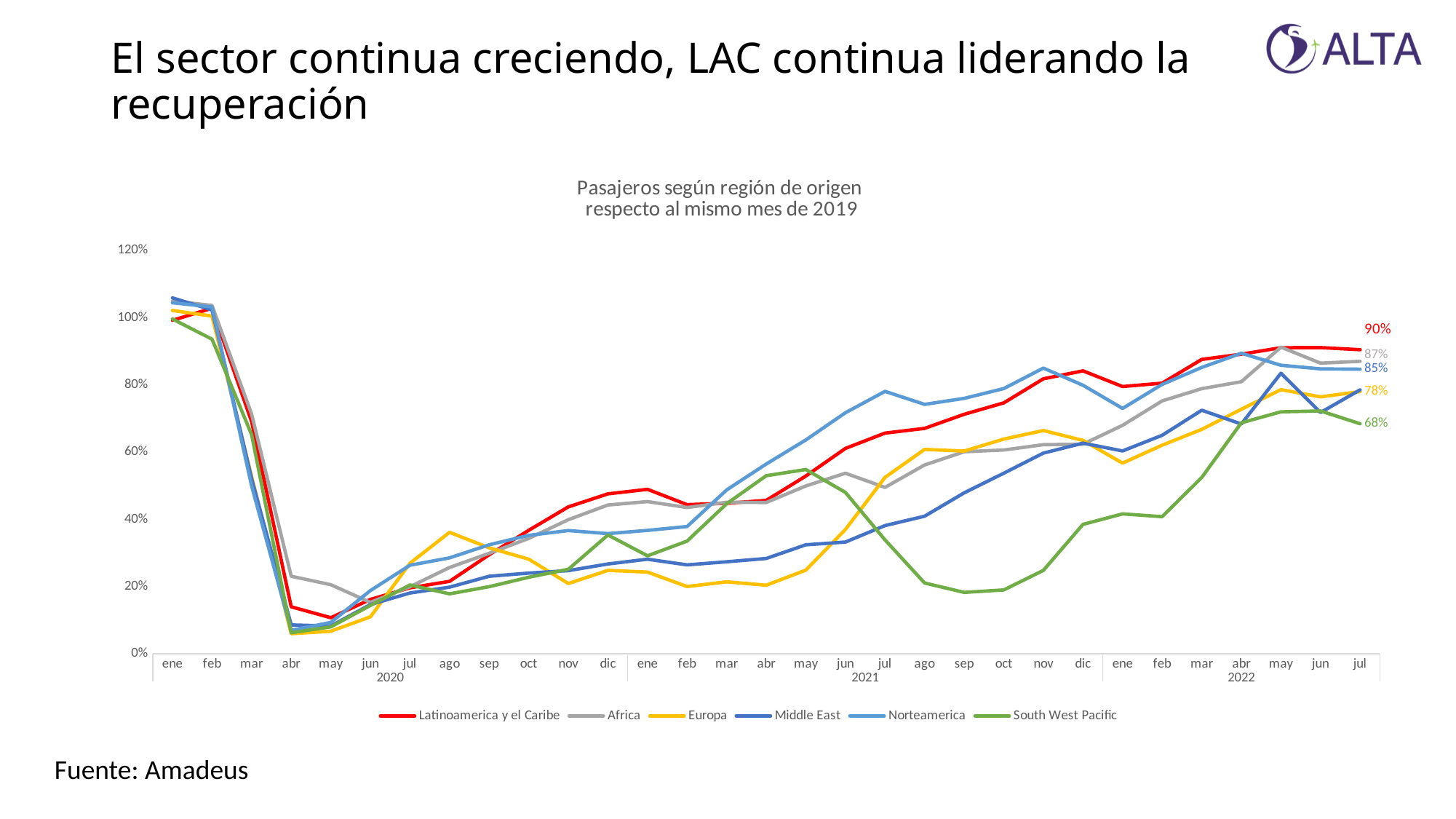
How many series does the legend list? 6 What kind of chart is shown on the slide? line chart Which region has the lowest value in jul 2022? South West Pacific What is the value for Africa in jul 2022? 87% What is the difference between Latinoamerica y el Caribe and South West Pacific in jul 2022? 22 percentage points Is the value for Norteamerica in jul 2021 greater or less than 60%? greater What is the value for Europa in jul 2022? 78% Which region has the highest value in jul 2022? Latinoamerica y el Caribe What is the title of the chart? Pasajeros según región de origen respecto al mismo mes de 2019 What is the value for Norteamerica in jul 2022? 85% What is the value for South West Pacific in jul 2022? 68% What is the value for Latinoamerica y el Caribe in jul 2022? 90%